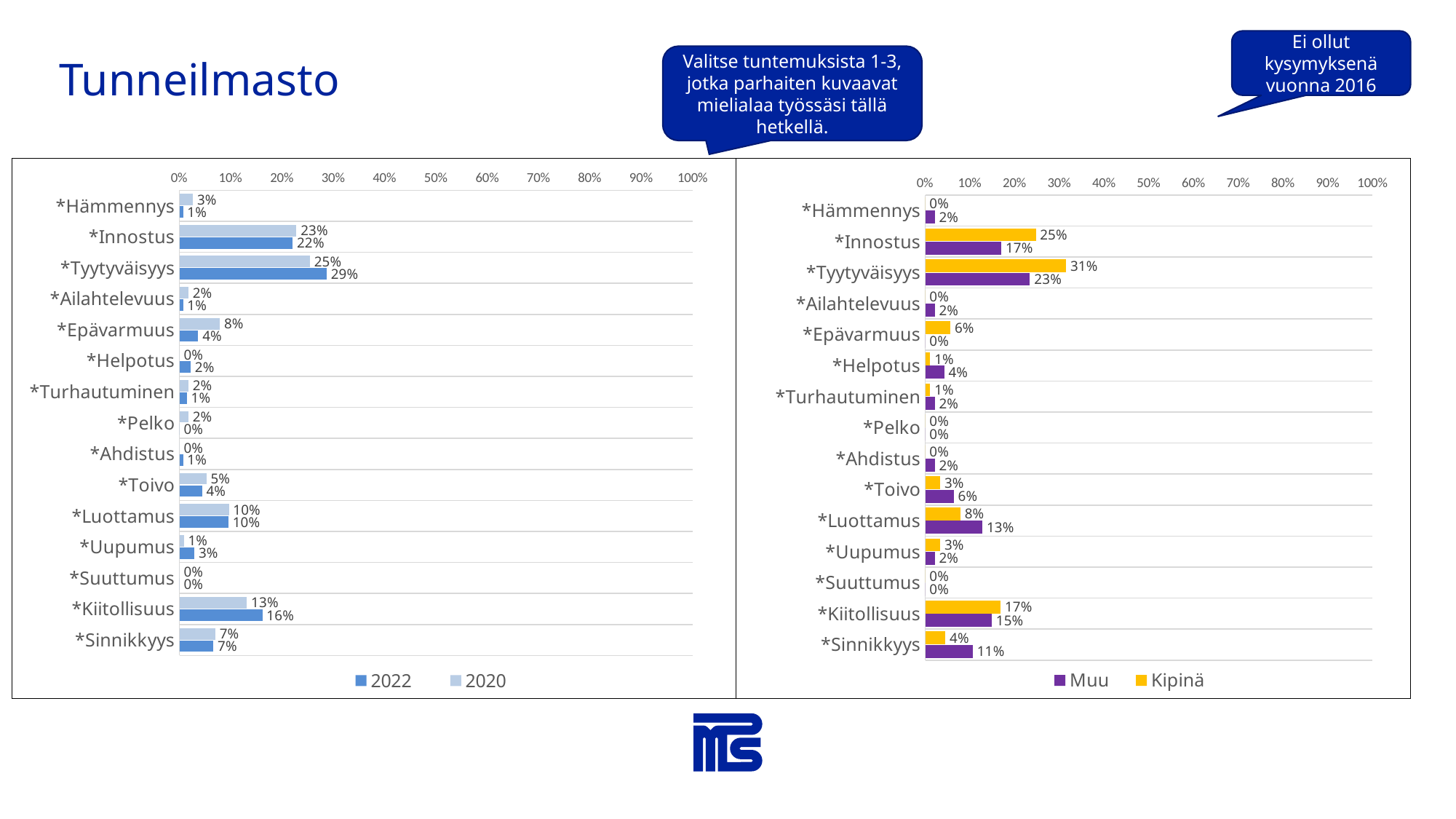
What type of chart is the left chart? Bar chart How many series does the legend of the right chart list? 2 In the right chart, what is the difference between the Kipinä and Muu values for *Luottamus? 5% In the right chart, which is larger for *Toivo: the Muu value or the Kipinä value? Muu In the right chart, which category has the highest Kipinä value? *Tyytyväisyys In the left chart, what is the difference between the 2022 and 2020 values for *Epävarmuus? 4% In the right chart, what is the Muu value for *Sinnikkyys? 11% How many categories are shown in the left chart? 15 In the right chart, what is the Kipinä value for *Innostus? 25% In the left chart, what is the 2020 value for *Kiitollisuus? 13% In the left chart, what is the 2022 value for *Tyytyväisyys? 29% In the left chart, which category has the highest 2022 value? *Tyytyväisyys